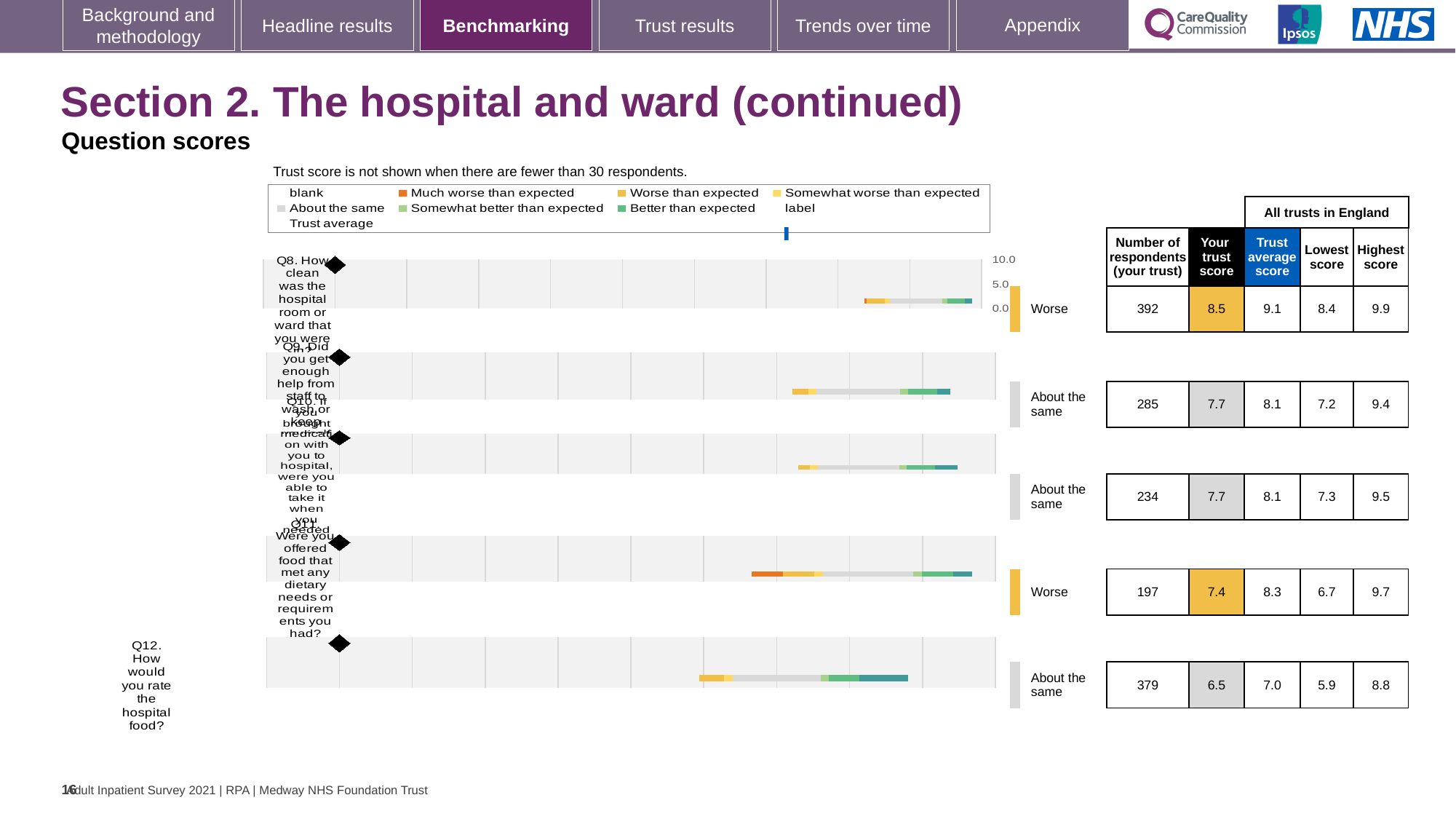
How many respondents from the trust answered Q11 (food that met dietary needs)? 197 What is the difference between the trust average score and your trust score for Q8? 0.6 What kind of chart is used to show the question scores on this slide? bar chart What colour represents 'Much worse than expected' in the legend? Orange For Q11, which is larger: your trust score or the trust average score? Trust average score What is the highest score across all trusts in England for Q9 (enough help from staff to wash or keep clean)? 9.4 Which question has the highest 'Your trust score'? Q8 What is the 'Your trust score' for Q8 (How clean was the hospital room or ward)? 8.5 What benchmark category is shown next to Q8's bar? Worse What is the 'Trust average score' for Q12 (How would you rate the hospital food)? 7.0 How many questions (Q8 to Q12) are plotted in the chart? 5 Which question has the lowest 'Your trust score'? Q12